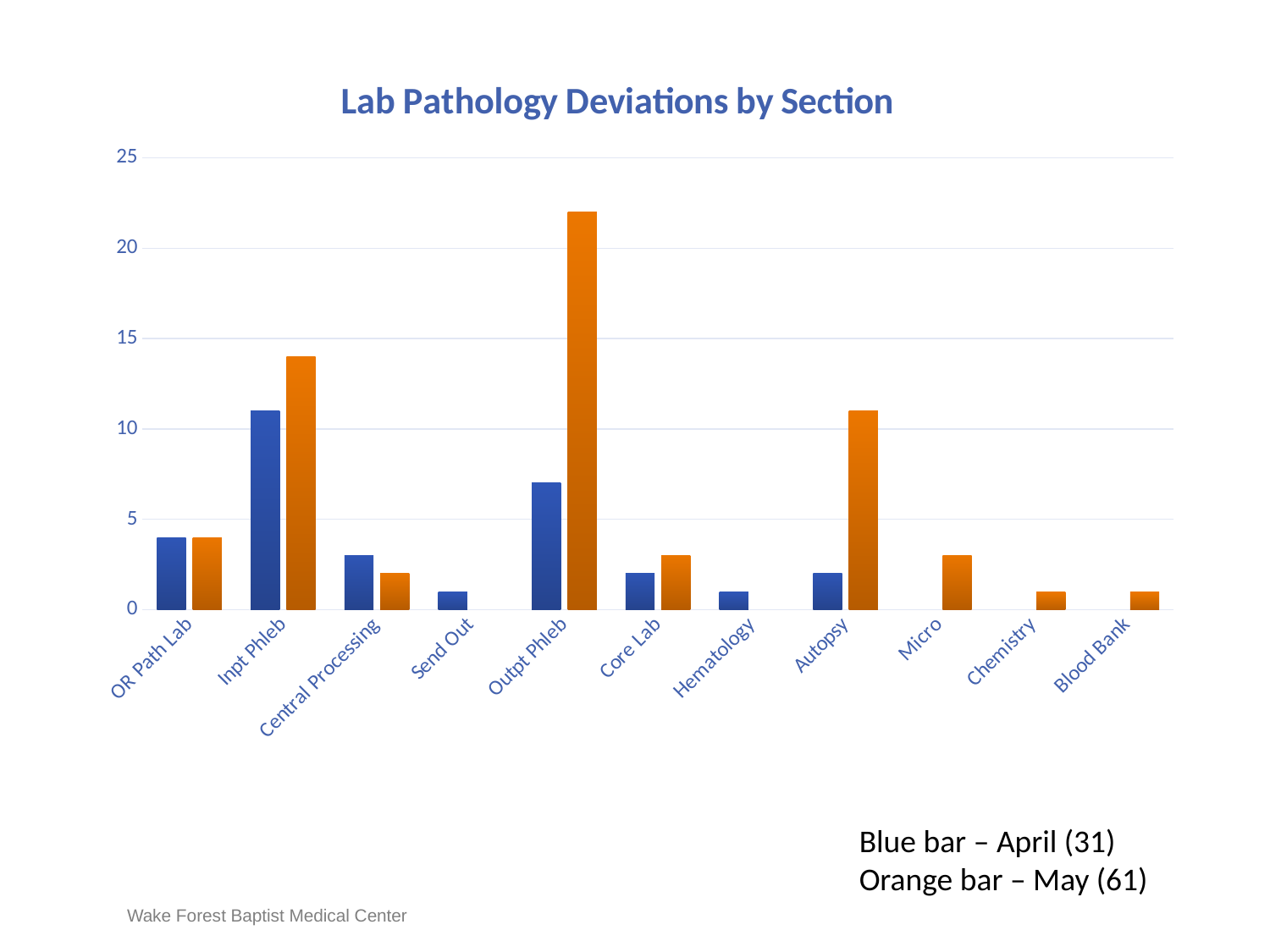
Is the blue (April) value for Inpt Phleb greater or less than 10? greater How many sections (categories) are shown on the x axis of the chart? 11 Is the orange (May) value for Autopsy greater or less than 15? less Which is larger for Central Processing, the blue (April) bar or the orange (May) bar? blue (April) Is the blue (April) value for Outpt Phleb greater or less than 5? greater Which section has the highest blue (April) bar? Inpt Phleb What is the title of the chart? Lab Pathology Deviations by Section Which is larger for Inpt Phleb, the blue (April) bar or the orange (May) bar? orange (May) According to the slide text, which month do the orange bars represent? May What kind of chart is shown on the slide? bar chart Which section has the highest orange (May) bar? Outpt Phleb